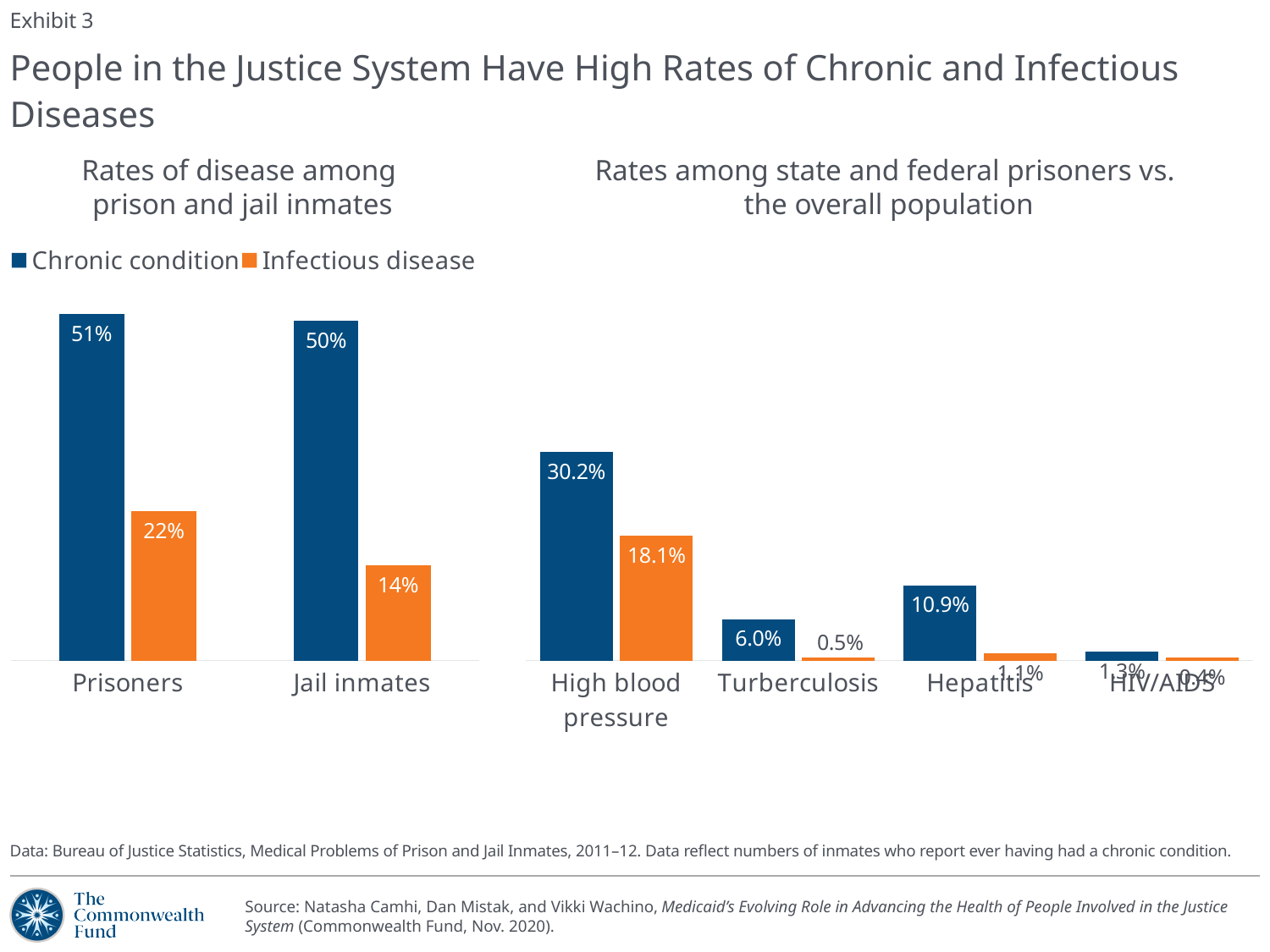
In the chart 'Rates of disease among prison and jail inmates', what is the chronic condition rate for prisoners? 51% What type of chart is 'Rates among state and federal prisoners vs. the overall population'? Bar chart In the chart 'Rates among state and federal prisoners vs. the overall population', which condition has the lowest orange bar? HIV/AIDS In the chart 'Rates among state and federal prisoners vs. the overall population', what is the value of the orange bar for turberculosis? 0.5% In the chart 'Rates of disease among prison and jail inmates', what is the infectious disease rate for jail inmates? 14% How many conditions are shown on the x axis of the chart 'Rates among state and federal prisoners vs. the overall population'? 4 In the chart 'Rates among state and federal prisoners vs. the overall population', which condition has the highest blue bar? High blood pressure In the chart 'Rates among state and federal prisoners vs. the overall population', what is the value of the blue bar for hepatitis? 10.9% In the chart 'Rates of disease among prison and jail inmates', what is the difference between the chronic condition rate and the infectious disease rate for prisoners? 29% In the chart 'Rates of disease among prison and jail inmates', which group has the higher infectious disease rate, prisoners or jail inmates? Prisoners How many series does the legend of the chart 'Rates of disease among prison and jail inmates' list? 2 In the chart 'Rates among state and federal prisoners vs. the overall population', what is the value of the blue bar for high blood pressure? 30.2%